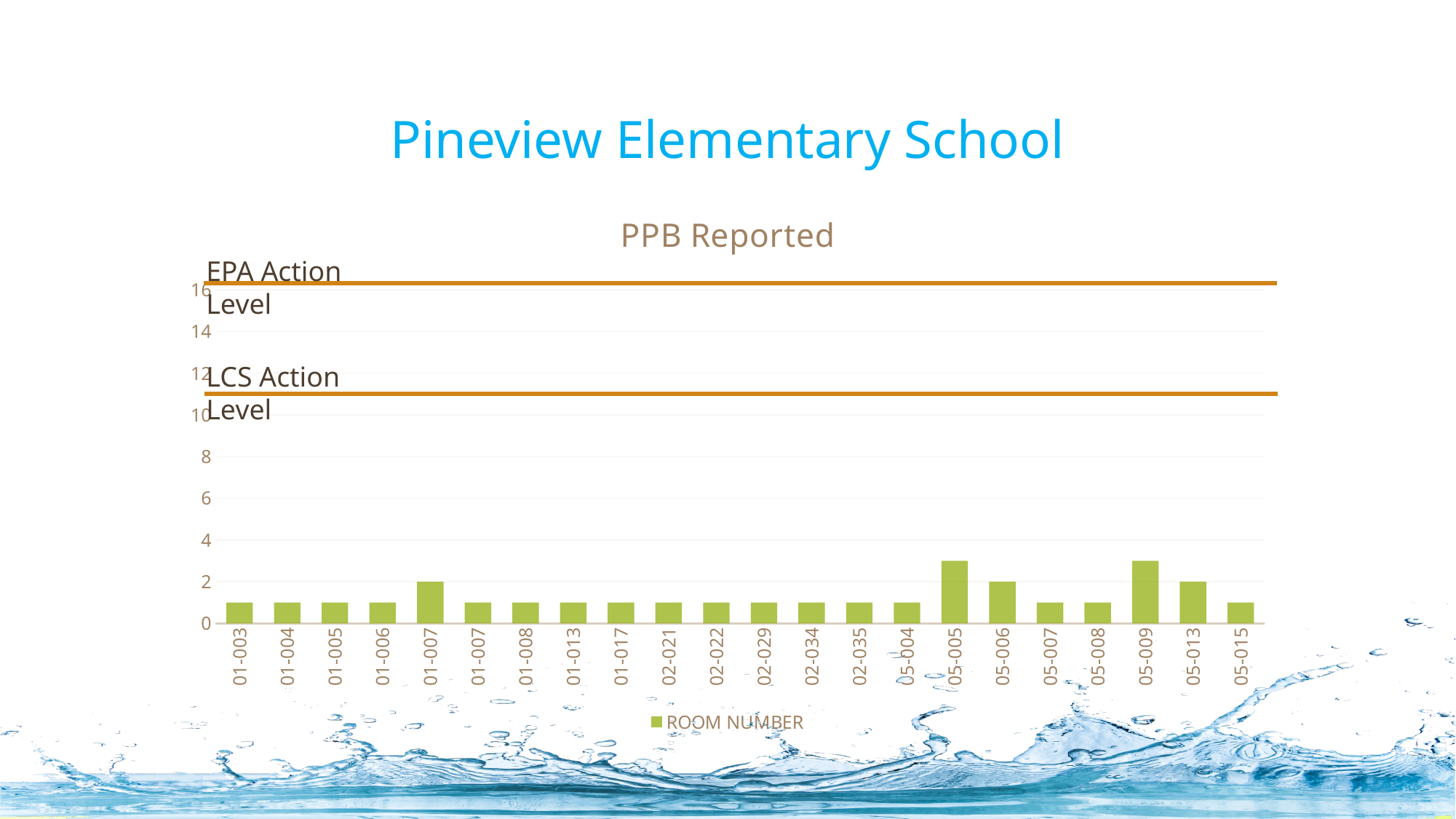
What is the PPB value reported for room 05-006? 2 What is the legend entry for the plotted series? ROOM NUMBER How many room numbers (categories) are plotted on the x axis? 22 Is the value for room 05-009 greater or less than 4? less What is the title of the chart? PPB Reported Is the value for room 01-003 greater or less than 2? less How many series does the legend list? 1 What is the PPB value reported for room 05-013? 2 Is the value for room 05-005 greater or less than 2? greater Which has the larger value, room 05-009 or room 02-021? 05-009 What kind of chart is shown on the slide? bar chart